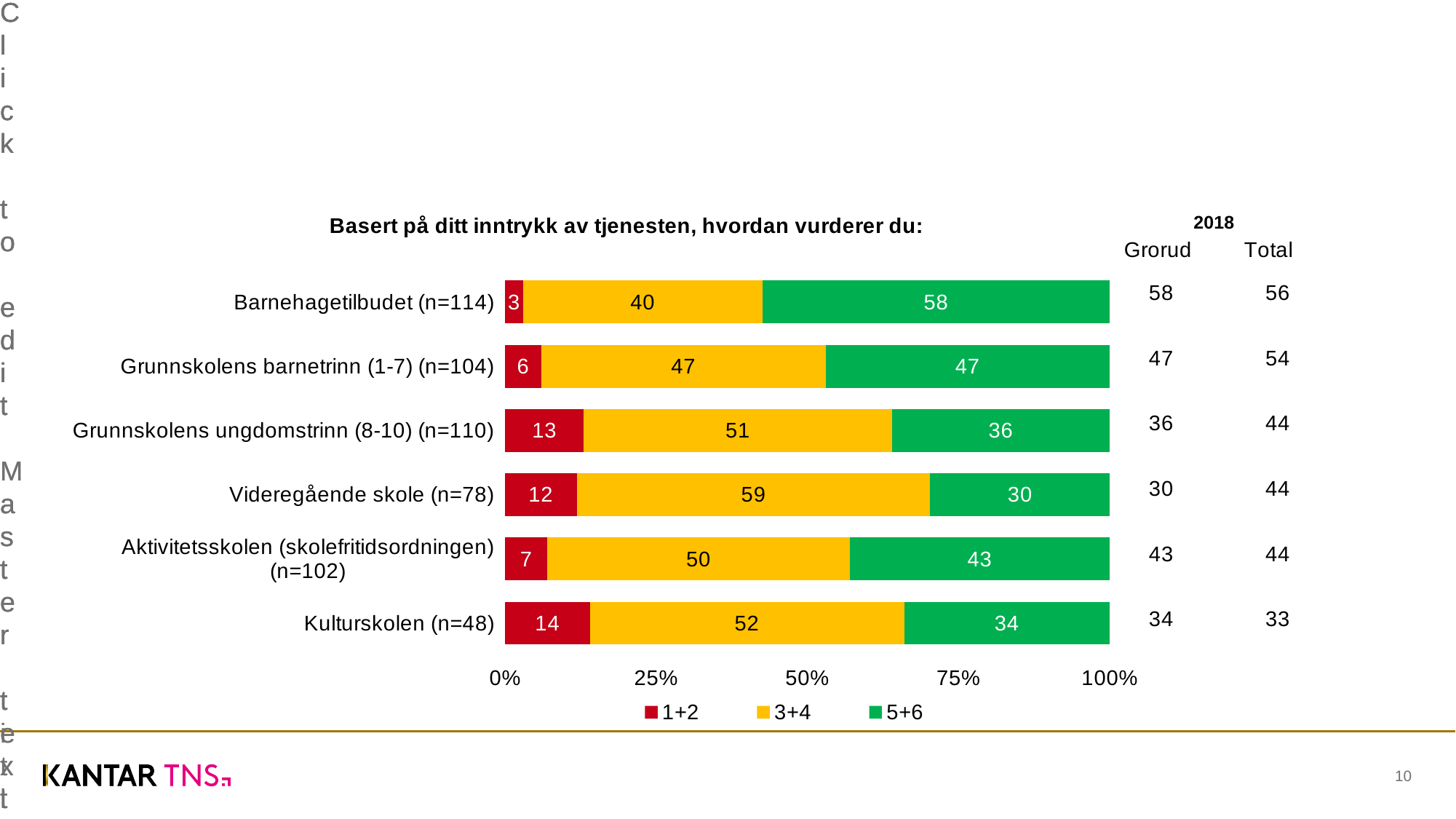
How many categories are shown in the chart? 6 How many series does the legend list? 3 Which is larger: the 3+4 value for Grunnskolens ungdomstrinn (8-10) (n=110) or the 3+4 value for Aktivitetsskolen (skolefritidsordningen) (n=102)? Grunnskolens ungdomstrinn (8-10) (n=110) Which category has the lowest 1+2 value? Barnehagetilbudet (n=114) Which category has the highest 5+6 value? Barnehagetilbudet (n=114) What kind of chart is shown on the slide? Stacked bar chart What is the value of the 1+2 segment for Kulturskolen (n=48)? 14 What is the value of the 3+4 segment for Videregående skole (n=78)? 59 What is the difference between the 5+6 values for Barnehagetilbudet (n=114) and Videregående skole (n=78)? 28 What is the total of the stacked bar for Grunnskolens barnetrinn (1-7) (n=104)? 100 What is the title of the chart? Basert på ditt inntrykk av tjenesten, hvordan vurderer du: What is the value of the 5+6 segment for Barnehagetilbudet (n=114)? 58